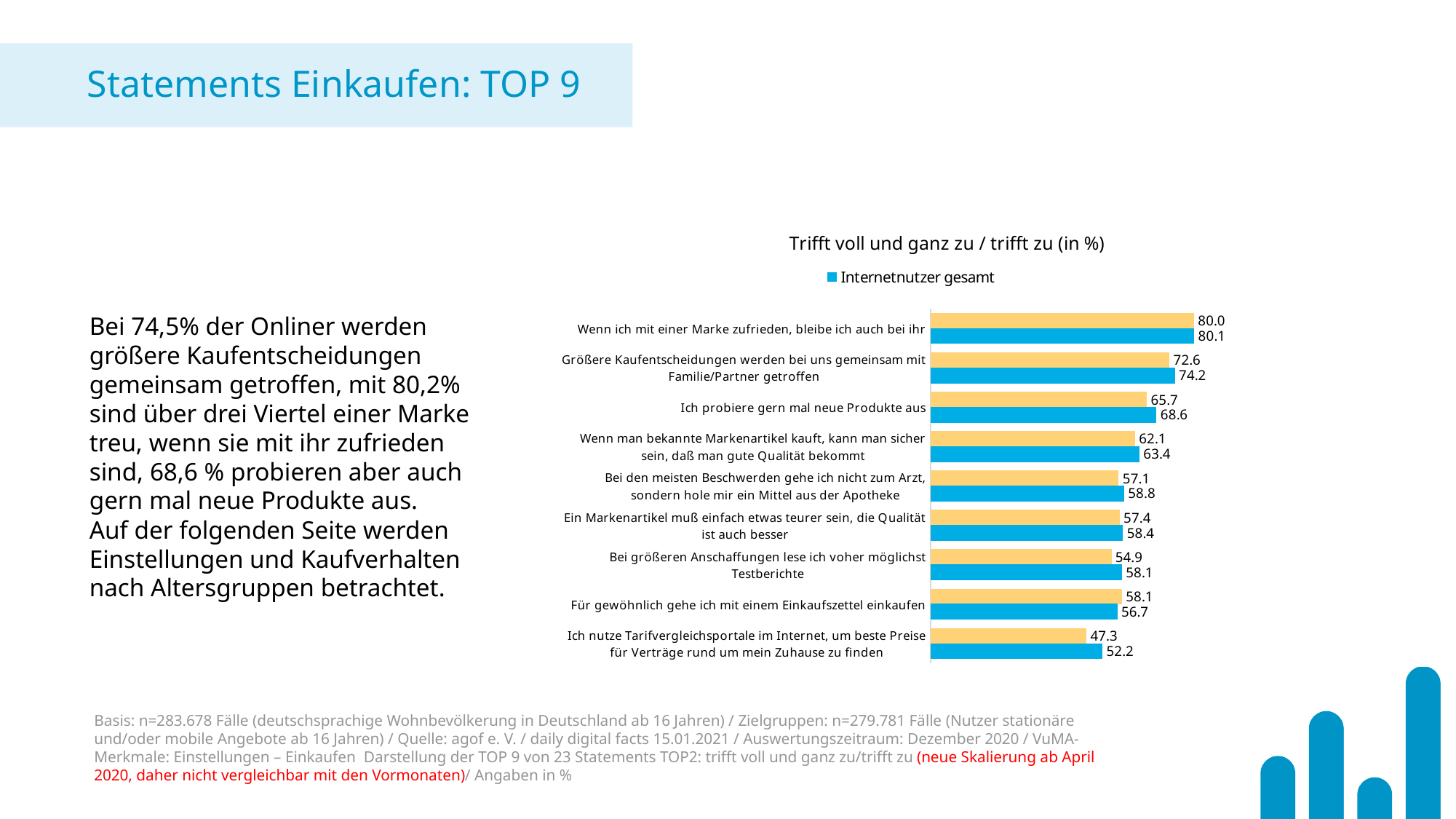
What kind of chart is shown on the slide? Bar chart What is the value for 'Internetnutzer gesamt' for the statement 'Bei den meisten Beschwerden gehe ich nicht zum Arzt, sondern hole mir ein Mittel aus der Apotheke'? 58.8 Which statement has the highest value for 'Internetnutzer gesamt'? Wenn ich mit einer Marke zufrieden, bleibe ich auch bei ihr Which statement has the lowest value for 'Internetnutzer gesamt'? Ich nutze Tarifvergleichsportale im Internet, um beste Preise für Verträge rund um mein Zuhause zu finden What is the value for 'Internetnutzer gesamt' for the statement 'Für gewöhnlich gehe ich mit einem Einkaufszettel einkaufen'? 56.7 For 'Internetnutzer gesamt', what is the difference between 'Wenn man bekannte Markenartikel kauft, kann man sicher sein, daß man gute Qualität bekommt' and 'Bei den meisten Beschwerden gehe ich nicht zum Arzt, sondern hole mir ein Mittel aus der Apotheke'? 4.6 For 'Internetnutzer gesamt', what is the difference between the highest statement (80.1) and the lowest statement (52.2)? 27.9 For 'Internetnutzer gesamt', which statement has the larger value: 'Größere Kaufentscheidungen werden bei uns gemeinsam mit Familie/Partner getroffen' or 'Ich probiere gern mal neue Produkte aus'? Größere Kaufentscheidungen werden bei uns gemeinsam mit Familie/Partner getroffen What is the value for 'Internetnutzer gesamt' for the statement 'Ich probiere gern mal neue Produkte aus'? 68.6 What is the title of the chart? Trifft voll und ganz zu / trifft zu (in %) How many statements are shown in the chart? 9 How many series does the chart legend list? 1